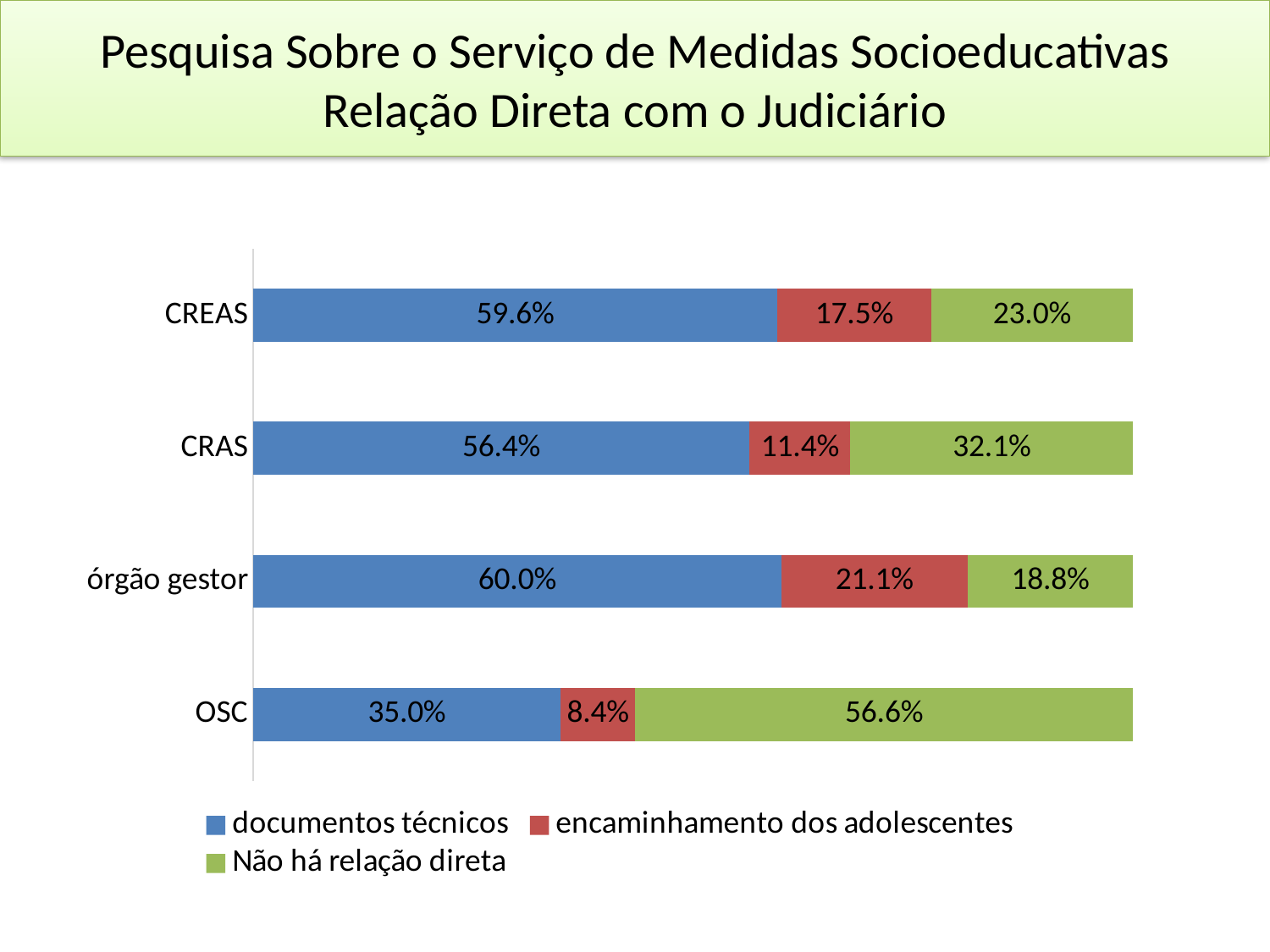
How many categories are shown on the chart? 4 What is the value of 'encaminhamento dos adolescentes' for órgão gestor? 21.1% How many series does the legend list? 3 Which category has the lowest value for 'documentos técnicos'? OSC What is the difference between the 'documentos técnicos' values for CREAS and CRAS? 3.2 percentage points What is the value of 'Não há relação direta' for CRAS? 32.1% Which colour represents 'Não há relação direta' in the chart? Green What is the value of 'documentos técnicos' for CREAS? 59.6% Which category has the highest value for 'Não há relação direta'? OSC What type of chart is shown on the slide? Stacked bar chart Which category has the highest value for 'encaminhamento dos adolescentes'? órgão gestor Which is larger for OSC: 'documentos técnicos' or 'Não há relação direta'? Não há relação direta